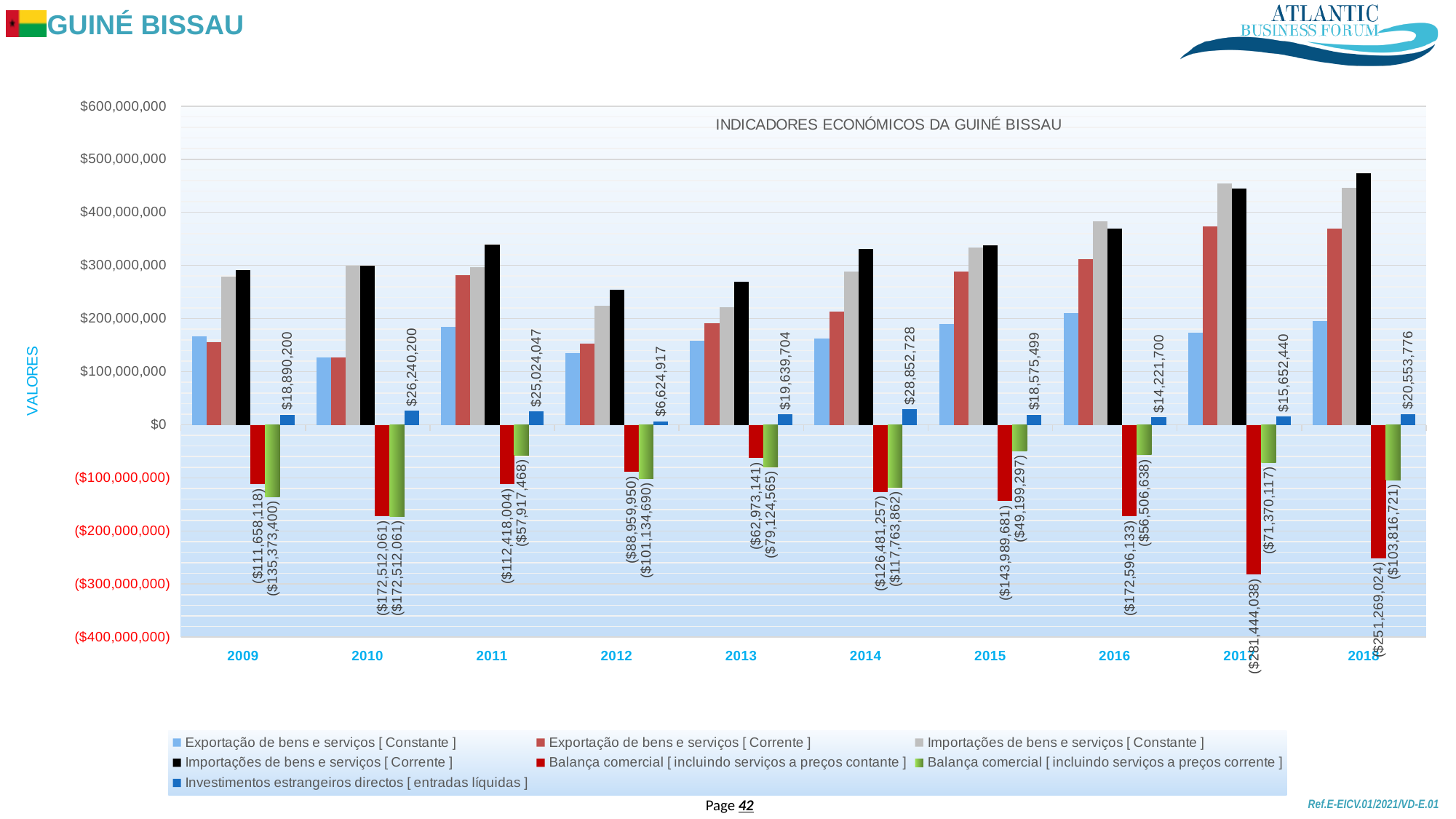
Overall, does Importações de bens e serviços [Corrente] rise or fall from 2009 to 2018? Rise Which year has the larger value for Exportação de bens e serviços [Constante], 2009 or 2016? 2016 What is the title of the chart? INDICADORES ECONÓMICOS DA GUINÉ BISSAU How many series does the chart legend list? 7 What is the value of Balança comercial [incluindo serviços a preços contante] in 2017? ($281,444,038) Is the value for Importações de bens e serviços [Corrente] in 2018 greater or less than $400,000,000? greater What kind of chart is shown on the slide? Bar chart In which year is Investimentos estrangeiros directos [entradas líquidas] the lowest? 2012 In which year is Investimentos estrangeiros directos [entradas líquidas] the highest? 2014 How many years are shown on the x axis of the chart? 10 What is the difference between Investimentos estrangeiros directos in 2010 and in 2009? $7,350,000 What is the value of Investimentos estrangeiros directos [entradas líquidas] in 2014? $28,852,728